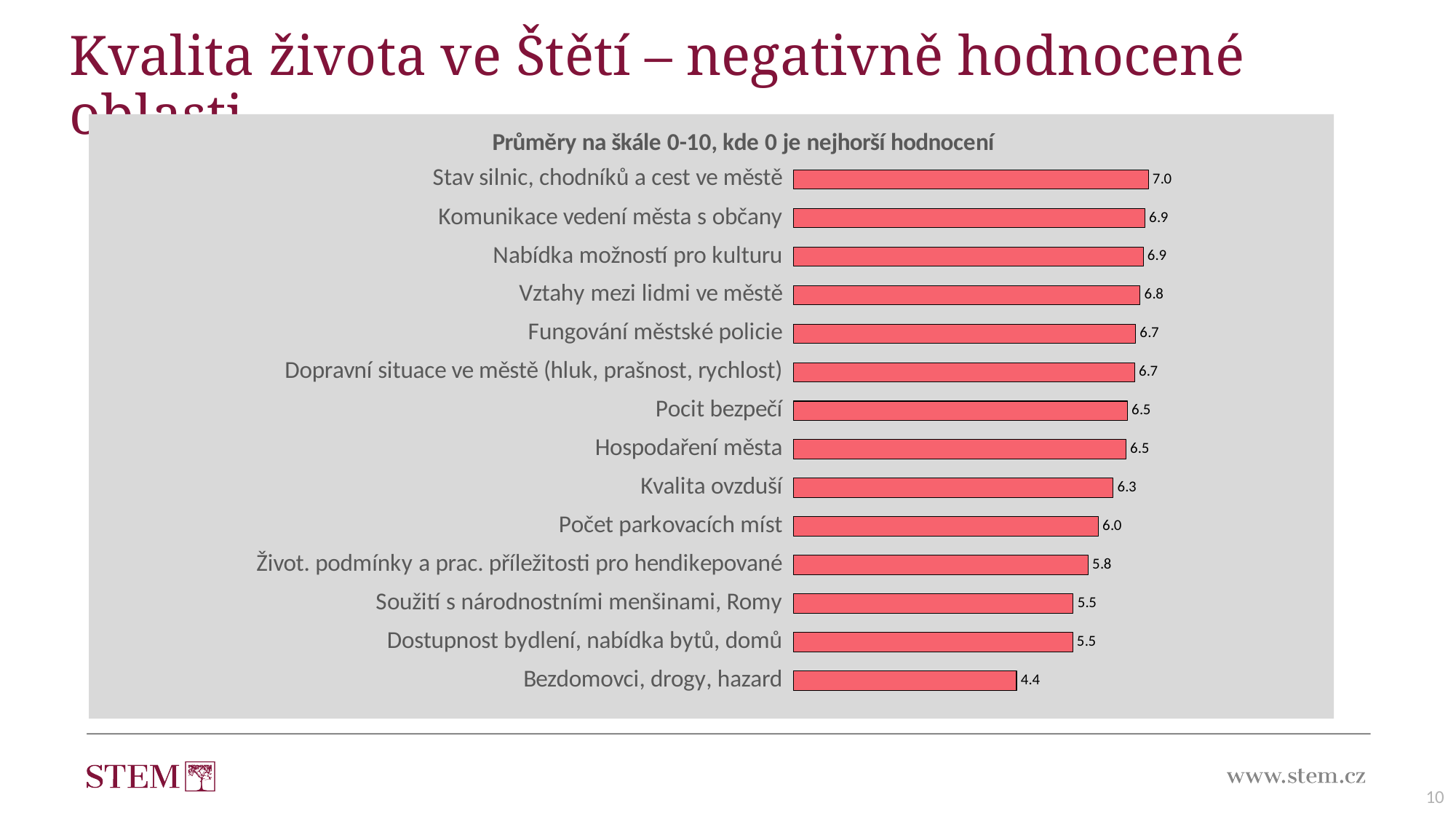
What is the title of the chart? Průměry na škále 0-10, kde 0 je nejhorší hodnocení How many categories are shown in the chart? 14 What is the value for "Stav silnic, chodníků a cest ve městě"? 7.0 What is the value for "Kvalita ovzduší"? 6.3 What kind of chart is shown on the slide? Bar chart What is the difference between the values for "Stav silnic, chodníků a cest ve městě" and "Bezdomovci, drogy, hazard"? 2.6 What is the difference between the values for "Pocit bezpečí" and "Počet parkovacích míst"? 0.5 What is the value for "Počet parkovacích míst"? 6.0 Which category has the lowest value? Bezdomovci, drogy, hazard What is the value for "Bezdomovci, drogy, hazard"? 4.4 Which is larger: the value for "Vztahy mezi lidmi ve městě" or the value for "Kvalita ovzduší"? Vztahy mezi lidmi ve městě Which category has the highest value? Stav silnic, chodníků a cest ve městě